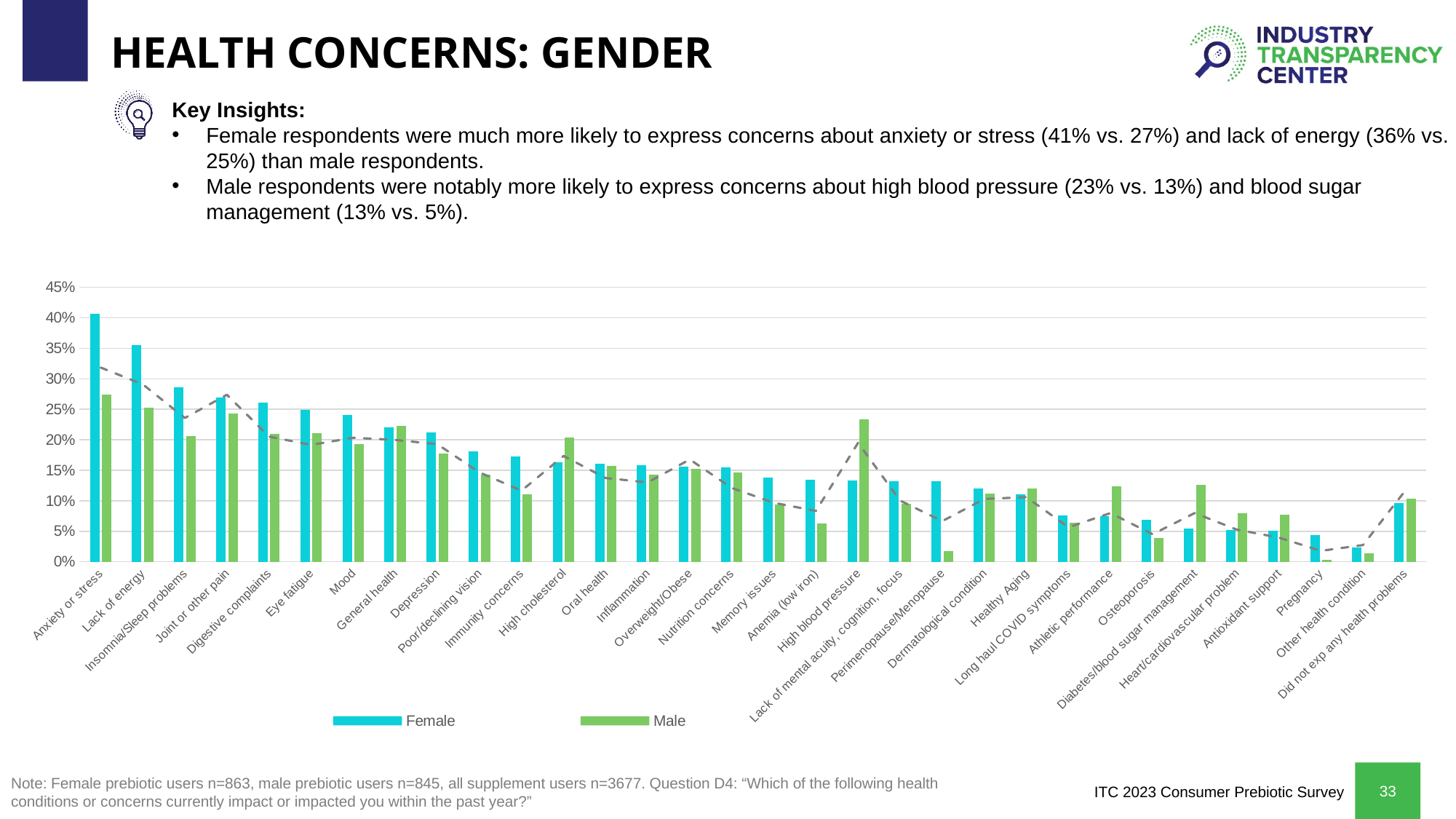
Which category has the highest Male value? Anxiety or stress What kind of chart is shown on the slide? Combination bar and line chart Is the Female value for Anxiety or stress greater or less than 35%? greater Which category has the lowest Male value? Pregnancy Is the Male value for High blood pressure greater or less than 20%? greater How many series does the legend list? 2 For High cholesterol, which is larger, the Female or the Male value? Male Which colour represents the Male series in the legend? Green Is the Male value for Perimenopause/Menopause greater or less than 5%? less For Lack of energy, which is larger, the Female or the Male value? Female How many health concern categories are shown on the x axis? 32 Which category has the highest Female value? Anxiety or stress